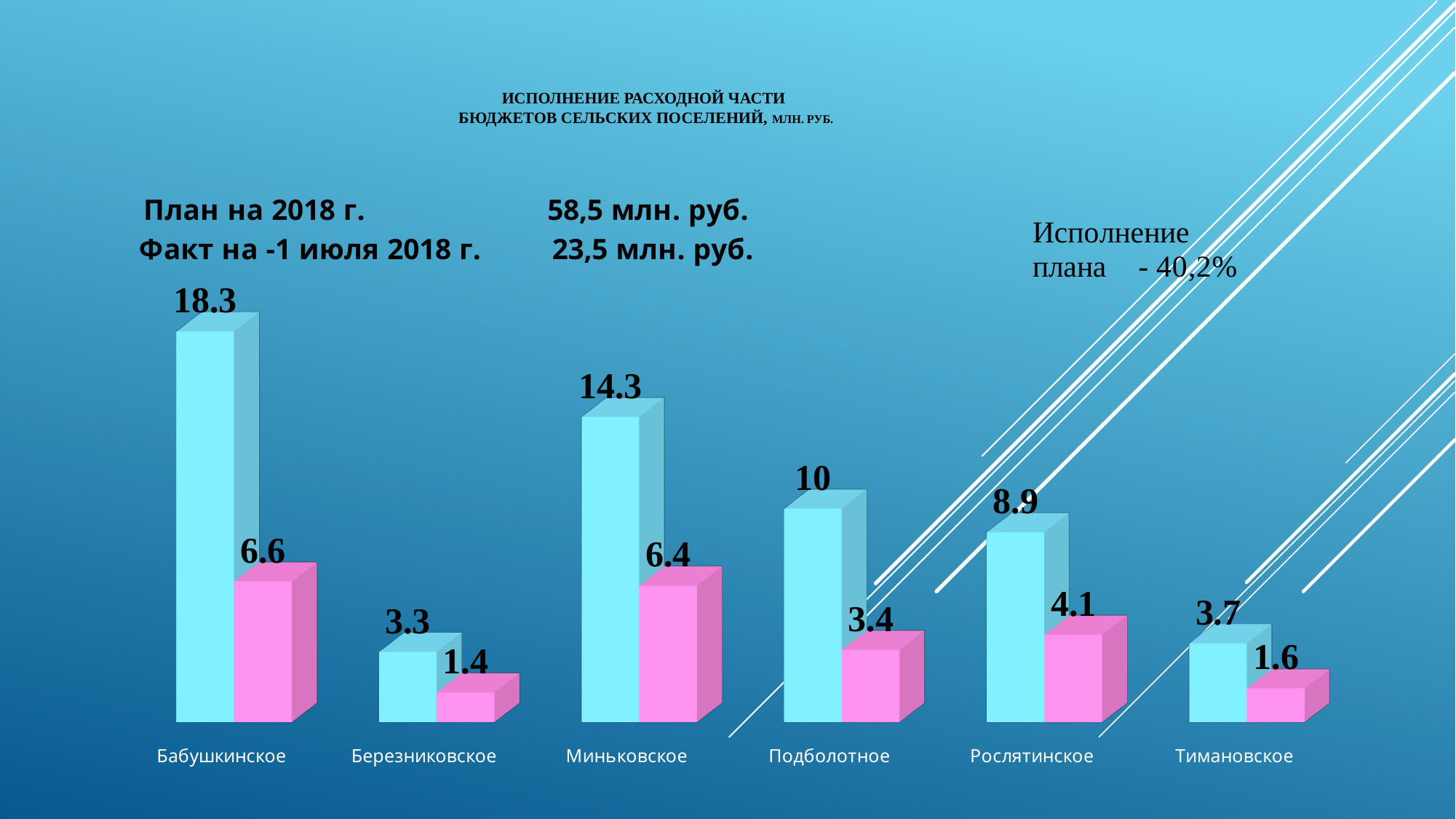
How many settlements (categories) are shown on the x axis of the chart? 6 Which settlement has the highest blue bar? Бабушкинское Which settlement has the lowest pink bar? Березниковское What is the difference between the blue bar and the pink bar for Рослятинское? 4.8 What is the value of the blue bar for Бабушкинское? 18.3 What is the value of the pink bar for Тимановское? 1.6 How many bars are plotted for each settlement in the chart? 2 What is the value of the blue bar for Подболотное? 10 Which is larger: the blue bar for Миньковское or the blue bar for Подболотное? Миньковское What is the value of the pink bar for Миньковское? 6.4 What type of chart is shown on the slide? bar chart According to the text on the slide, what is the plan execution percentage (Исполнение плана)? 40,2%